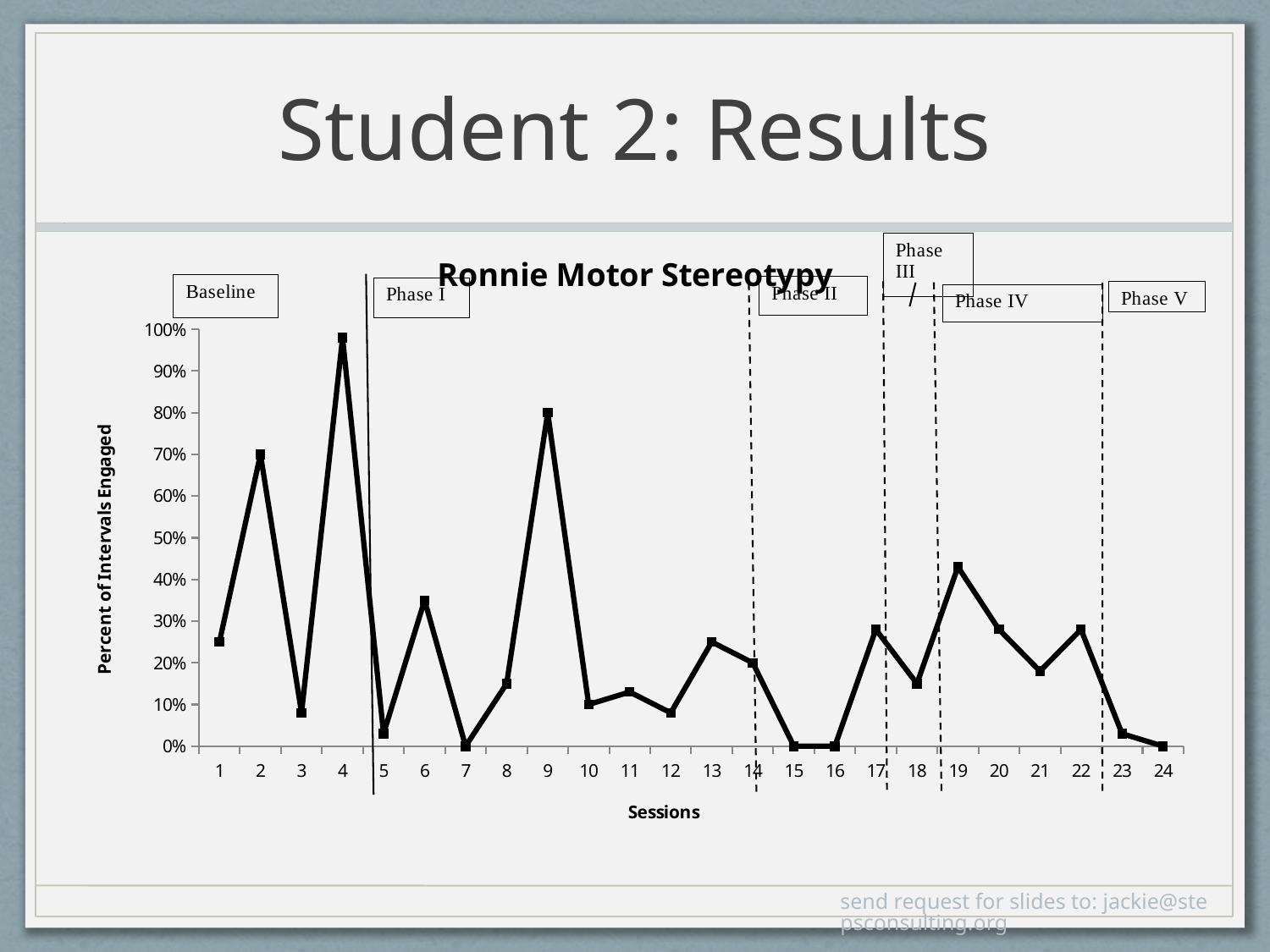
How many sessions are plotted on the x axis? 24 What is the label of the y axis? Percent of Intervals Engaged What is the percent of intervals engaged in session 2? 70% What is the percent of intervals engaged in session 9? 80% Which session has the larger value, session 9 or session 13? session 9 What is the percent of intervals engaged in session 15? 0% Is the value for session 6 greater or less than 40%? less Is the value for session 4 greater or less than 90%? greater What is the title of the chart? Ronnie Motor Stereotypy What type of chart is shown on the slide? line chart Which session has the highest percent of intervals engaged? 4 What is the percent of intervals engaged in session 10? 10%